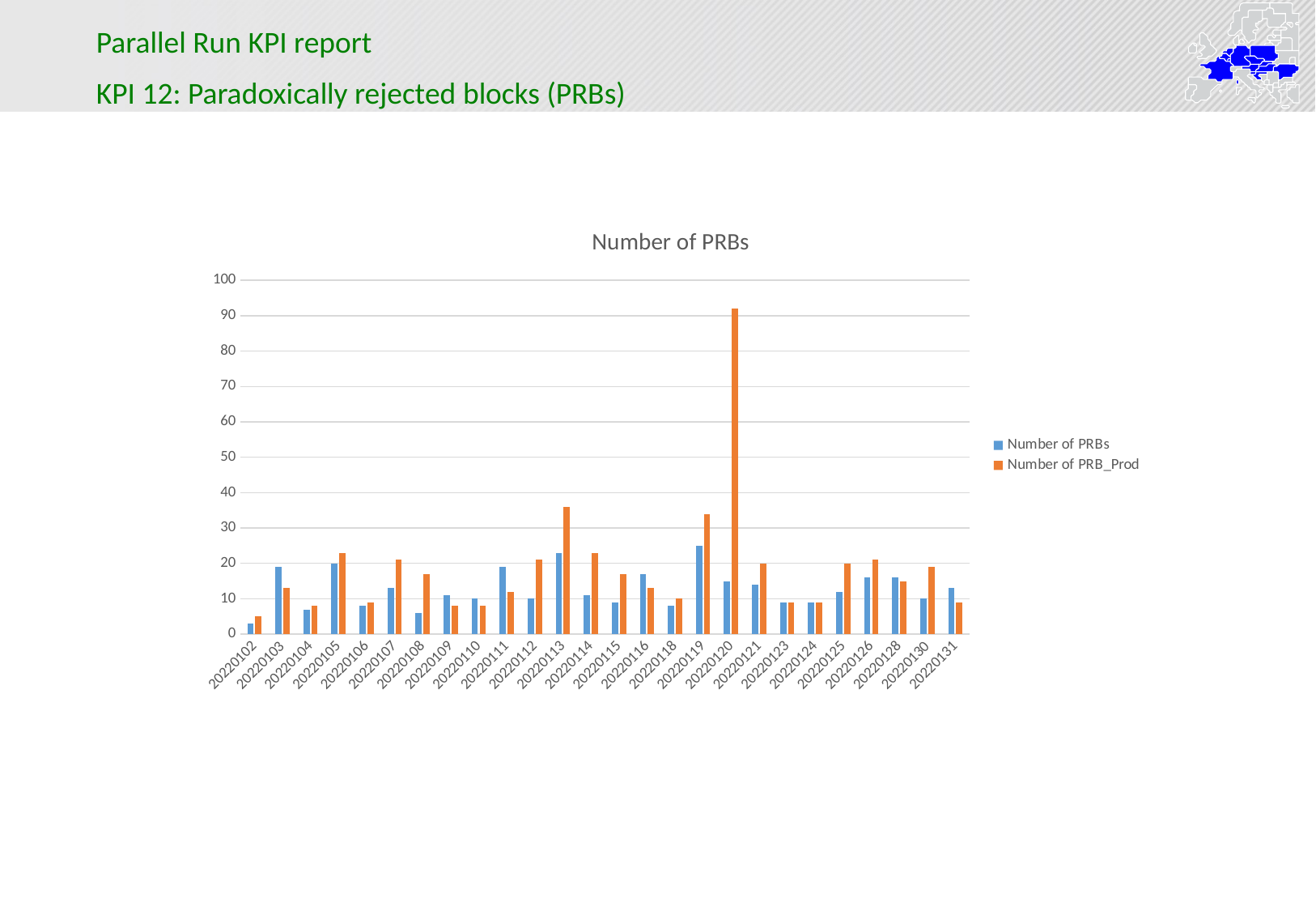
Is the value for Number of PRBs on 20220119 greater or less than 20? greater How many date categories are shown on the x axis? 26 Which date has the highest value for Number of PRBs? 20220119 What kind of chart is shown on the slide? bar chart Is the value for Number of PRB_Prod on 20220113 greater or less than 30? greater What is the title of the chart? Number of PRBs Is the value for Number of PRB_Prod on 20220120 greater or less than 80? greater Which date has the highest value for Number of PRB_Prod? 20220120 On 20220103, which series has the larger value, Number of PRBs or Number of PRB_Prod? Number of PRBs How many series does the legend list? 2 On 20220113, which series has the larger value, Number of PRBs or Number of PRB_Prod? Number of PRB_Prod Which date has the lowest value for Number of PRBs? 20220102